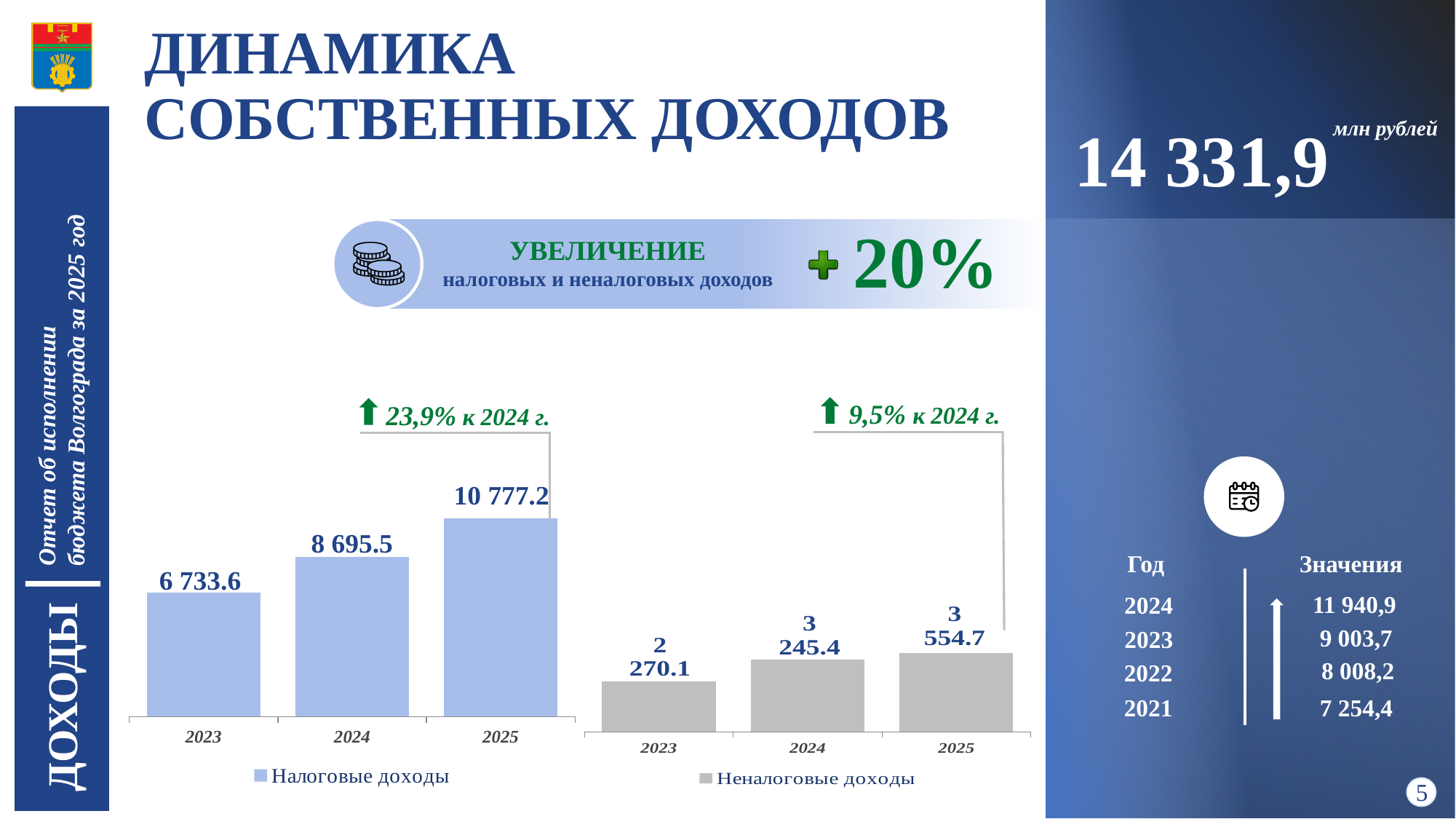
How many years are shown in the Неналоговые доходы chart? 3 What type of chart is the Налоговые доходы chart? Bar chart In the Налоговые доходы chart, what is the difference between the 2025 and 2024 values? 2 081.7 In the Неналоговые доходы chart, what is the value for 2023? 2 270.1 In the Налоговые доходы chart, which is larger: the value for 2024 or the value for 2023? 2024 In the Налоговые доходы chart, what is the value for 2025? 10 777.2 In the Налоговые доходы chart, which year has the highest value? 2025 In the Неналоговые доходы chart, what is the value for 2024? 3 245.4 In the Неналоговые доходы chart, do the values rise or fall from 2023 to 2025? Rise In the Налоговые доходы chart, what is the value for 2023? 6 733.6 In the Неналоговые доходы chart, what is the difference between the 2025 and 2024 values? 309.3 In the Неналоговые доходы chart, which year has the lowest value? 2023